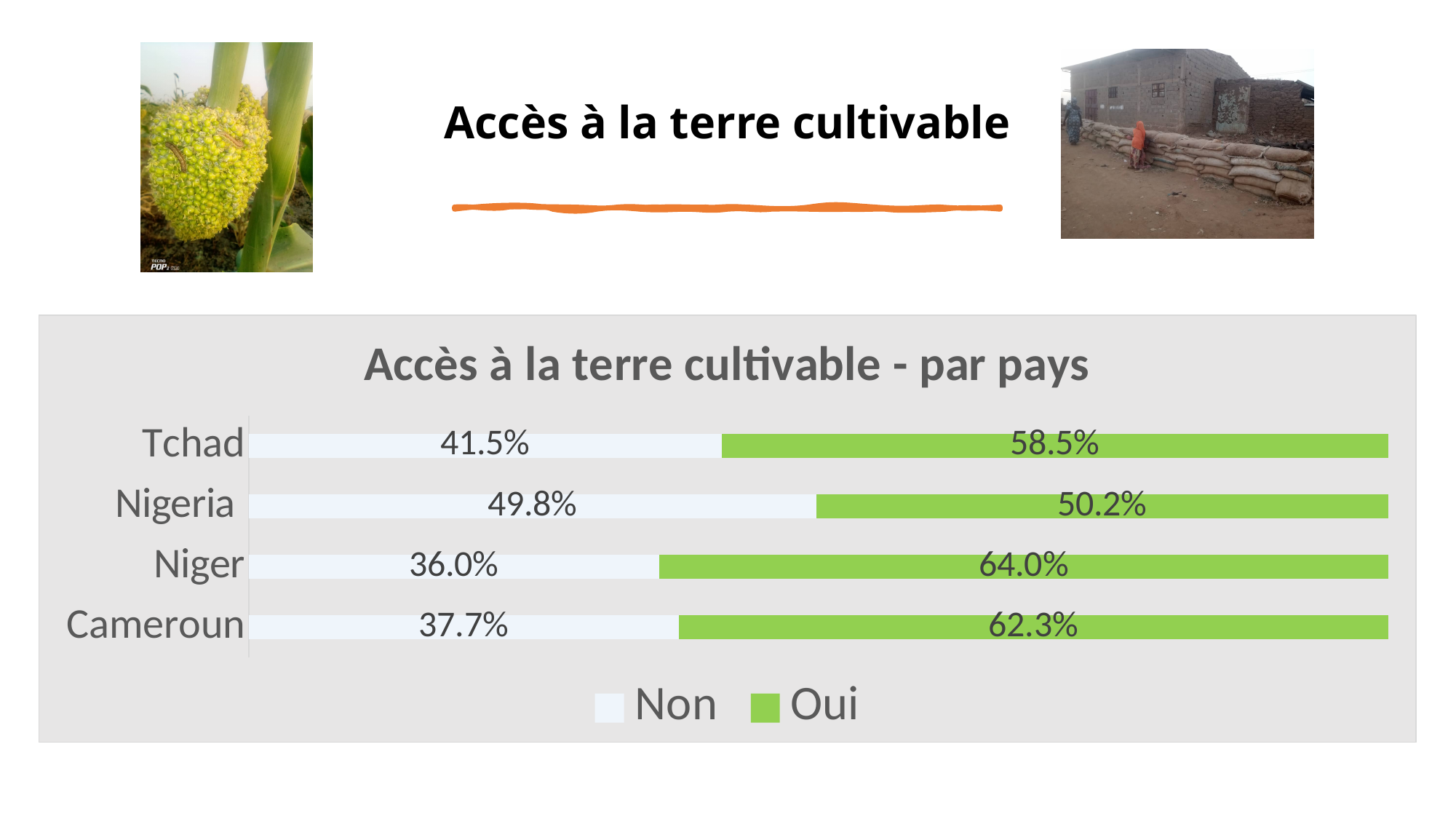
Which is larger, the 'Oui' value for Cameroun or the 'Oui' value for Tchad? Cameroun What is the 'Non' value for Cameroun? 37.7% Which country has the highest 'Non' value? Nigeria What is the 'Oui' value for Tchad? 58.5% What is the difference between the 'Oui' and 'Non' values for Tchad? 17.0% What is the 'Non' value for Nigeria? 49.8% Which country has the highest 'Oui' value? Niger What is the 'Oui' value for Niger? 64.0% How many countries are shown in the chart? 4 How many series does the legend list? 2 What kind of chart is shown on the slide? Stacked bar chart Which country has the lowest 'Oui' value? Nigeria